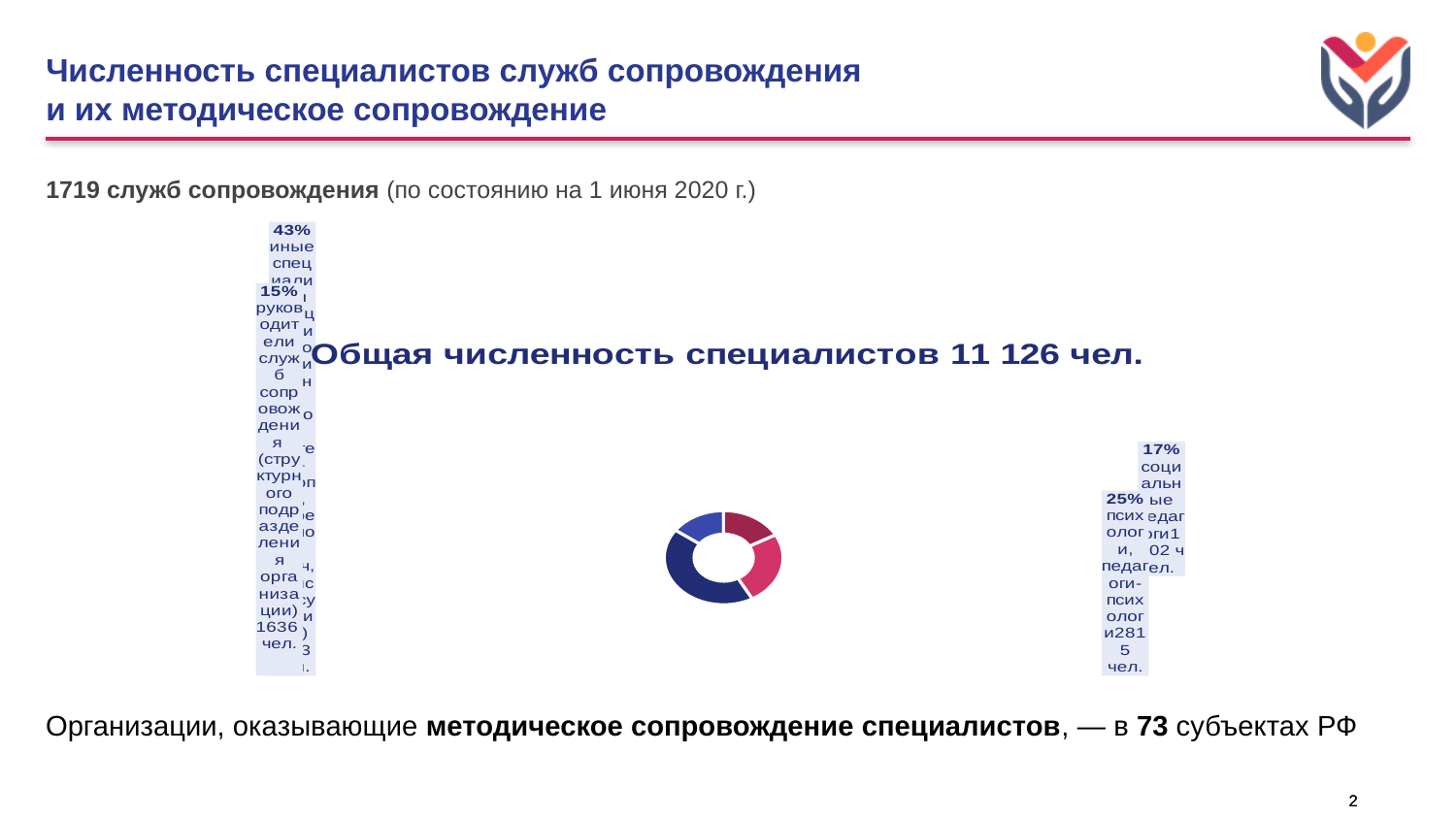
How many психологи, педагоги-психологи are there according to the chart label? 2815 чел. How many руководители служб сопровождения are there according to the chart label? 1636 чел. Which category has the smallest share in the chart? руководители служб сопровождения What is the total number of specialists stated in the chart title? 11 126 чел. What kind of chart is shown on the slide? Pie chart (doughnut) What share of the chart is taken by руководители служб сопровождения? 15% Which share is larger: психологи, педагоги-психологи or социальные педагоги? психологи, педагоги-психологи How many slices does the doughnut chart have? 4 What share of the chart is taken by психологи, педагоги-психологи? 25% Which category has the largest share in the chart? иные специалисты What share of the chart is taken by социальные педагоги? 17%